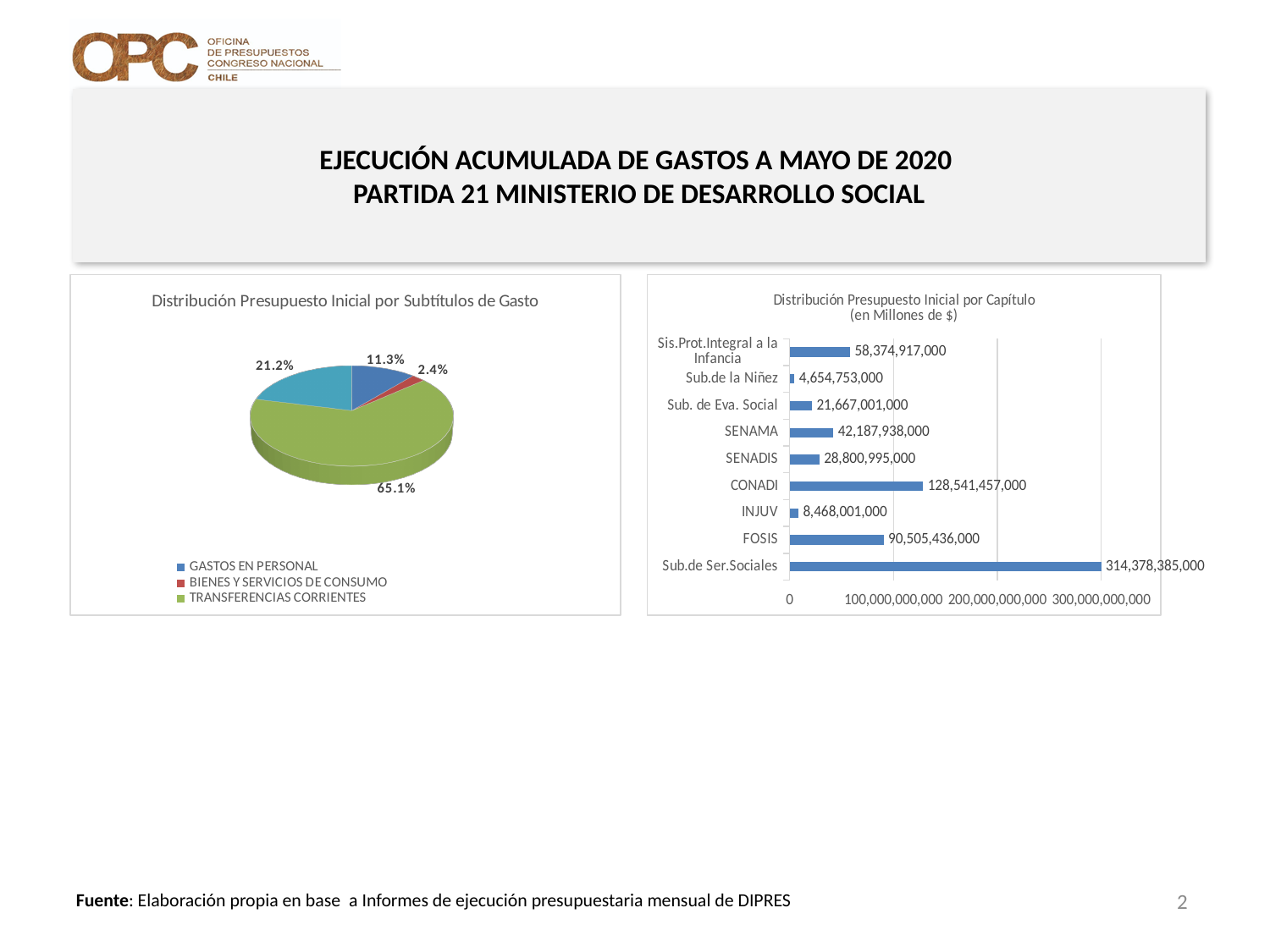
In the chart 'Distribución Presupuesto Inicial por Capítulo', which category has the highest value? Sub.de Ser.Sociales What kind of chart is the left chart, 'Distribución Presupuesto Inicial por Subtítulos de Gasto'? Pie chart In the chart 'Distribución Presupuesto Inicial por Capítulo', what is the value for CONADI? 128,541,457,000 In the pie chart 'Distribución Presupuesto Inicial por Subtítulos de Gasto', what share does BIENES Y SERVICIOS DE CONSUMO have? 2.4% In the chart 'Distribución Presupuesto Inicial por Capítulo', what is the difference between the values for CONADI and FOSIS? 38,036,021,000 In the chart 'Distribución Presupuesto Inicial por Capítulo', which is larger, SENAMA or SENADIS? SENAMA What kind of chart is the right chart, 'Distribución Presupuesto Inicial por Capítulo'? Bar chart In the chart 'Distribución Presupuesto Inicial por Capítulo', what is the value for FOSIS? 90,505,436,000 In the pie chart 'Distribución Presupuesto Inicial por Subtítulos de Gasto', what share does GASTOS EN PERSONAL have? 11.3% In the chart 'Distribución Presupuesto Inicial por Capítulo', which category has the lowest value? Sub.de la Niñez In the pie chart 'Distribución Presupuesto Inicial por Subtítulos de Gasto', what share does TRANSFERENCIAS CORRIENTES have? 65.1% How many categories are shown in the chart 'Distribución Presupuesto Inicial por Capítulo'? 9